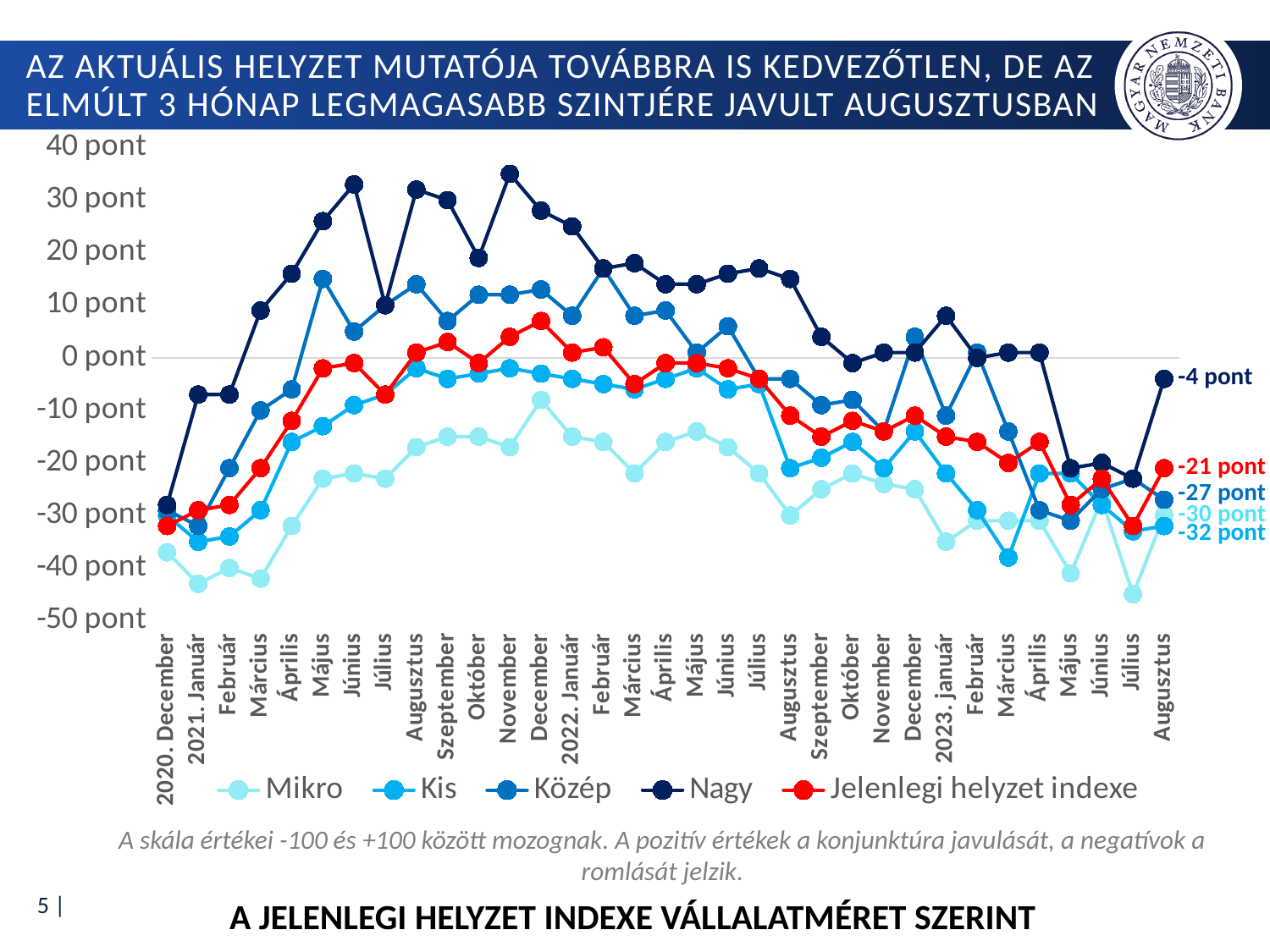
What is the title shown below the chart? A JELENLEGI HELYZET INDEXE VÁLLALATMÉRET SZERINT How many series does the legend list? 5 What is the value of the Nagy series in Augusztus 2023? -4 pont What is the value of the Jelenlegi helyzet indexe series in Augusztus 2023? -21 pont Is the value of the Mikro series in 2021 Január greater or less than -40 pont? less What kind of chart is shown on the slide? line chart In 2021 Május, which series has the larger value, Nagy or Mikro? Nagy Which series has the highest value in Augusztus 2023? Nagy What is the value of the Közép series in Augusztus 2023? -27 pont What is the difference between the Nagy value and the Jelenlegi helyzet indexe value in Augusztus 2023? 17 pont Is the value of the Nagy series in 2021 Június greater or less than 30 pont? greater What is the lowest value labelled for Augusztus 2023? -32 pont